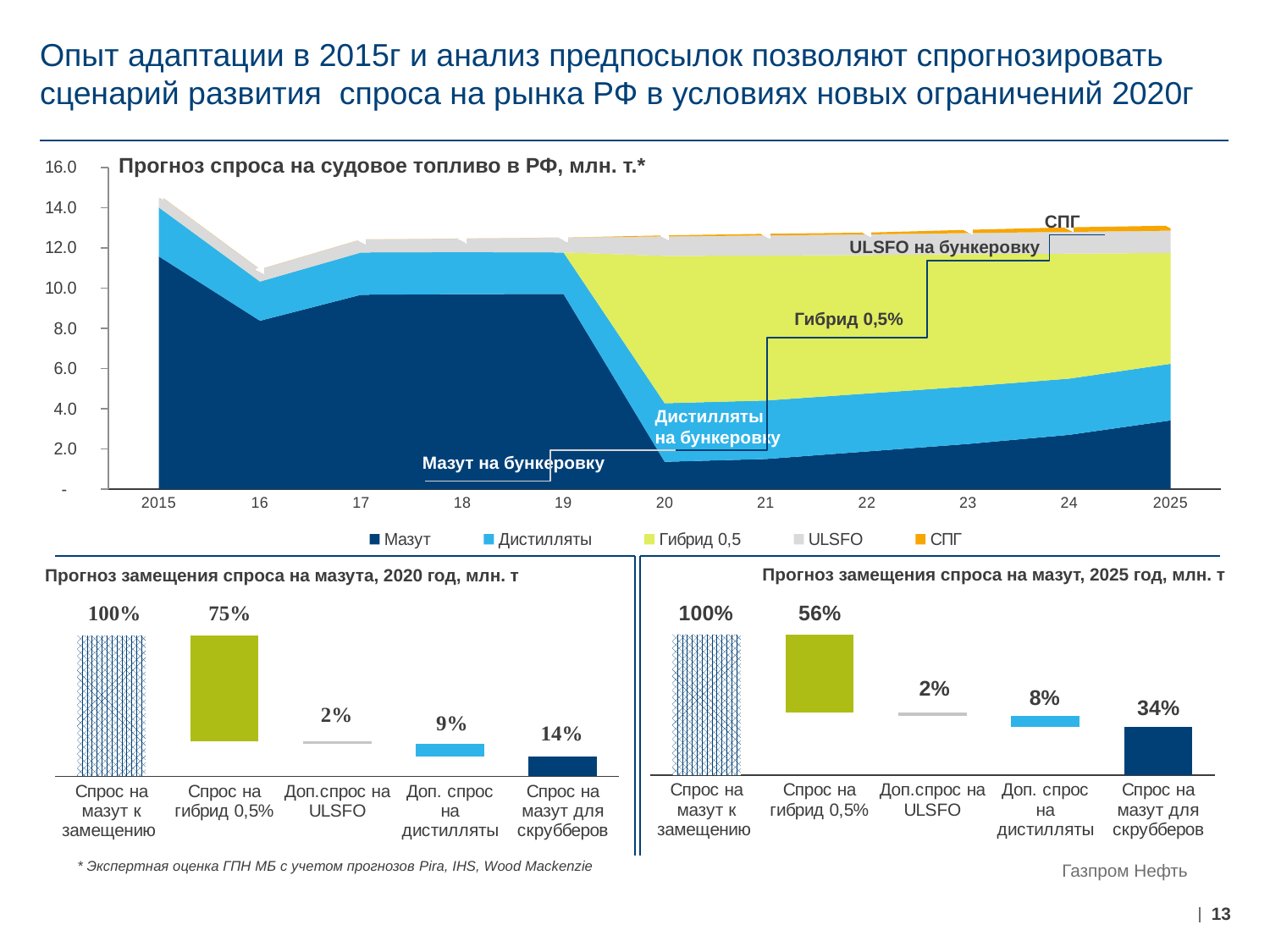
In the chart 'Прогноз замещения спроса на мазута, 2020 год, млн. т', which category has the lowest value? Доп.спрос на ULSFO In the chart 'Прогноз замещения спроса на мазут, 2025 год, млн. т', what is the value for 'Доп. спрос на дистилляты'? 8% In the chart 'Прогноз замещения спроса на мазут, 2025 год, млн. т', what is the value for 'Спрос на мазут для скрубберов'? 34% Which is larger: 'Спрос на мазут для скрубберов' in the 2020 chart or 'Спрос на мазут для скрубберов' in the 2025 chart? 2025 chart (34%) In the chart 'Прогноз замещения спроса на мазута, 2020 год, млн. т', what is the difference between 'Спрос на гибрид 0,5%' and 'Спрос на мазут для скрубберов'? 61% How many series does the legend of the chart 'Прогноз спроса на судовое топливо в РФ, млн. т.*' list? 5 In the chart 'Прогноз замещения спроса на мазут, 2025 год, млн. т', which category has the highest value? Спрос на мазут к замещению What kind of chart is 'Прогноз замещения спроса на мазут, 2025 год, млн. т'? Bar chart In the chart 'Прогноз замещения спроса на мазута, 2020 год, млн. т', what is the value for 'Спрос на гибрид 0,5%'? 75% In the chart 'Прогноз спроса на судовое топливо в РФ, млн. т.*', which series is shown in orange in the legend? СПГ In the chart 'Прогноз замещения спроса на мазут, 2025 год, млн. т', what is the difference between 'Спрос на гибрид 0,5%' and 'Спрос на мазут для скрубберов'? 22% How many years are shown on the x axis of the chart 'Прогноз спроса на судовое топливо в РФ, млн. т.*'? 11